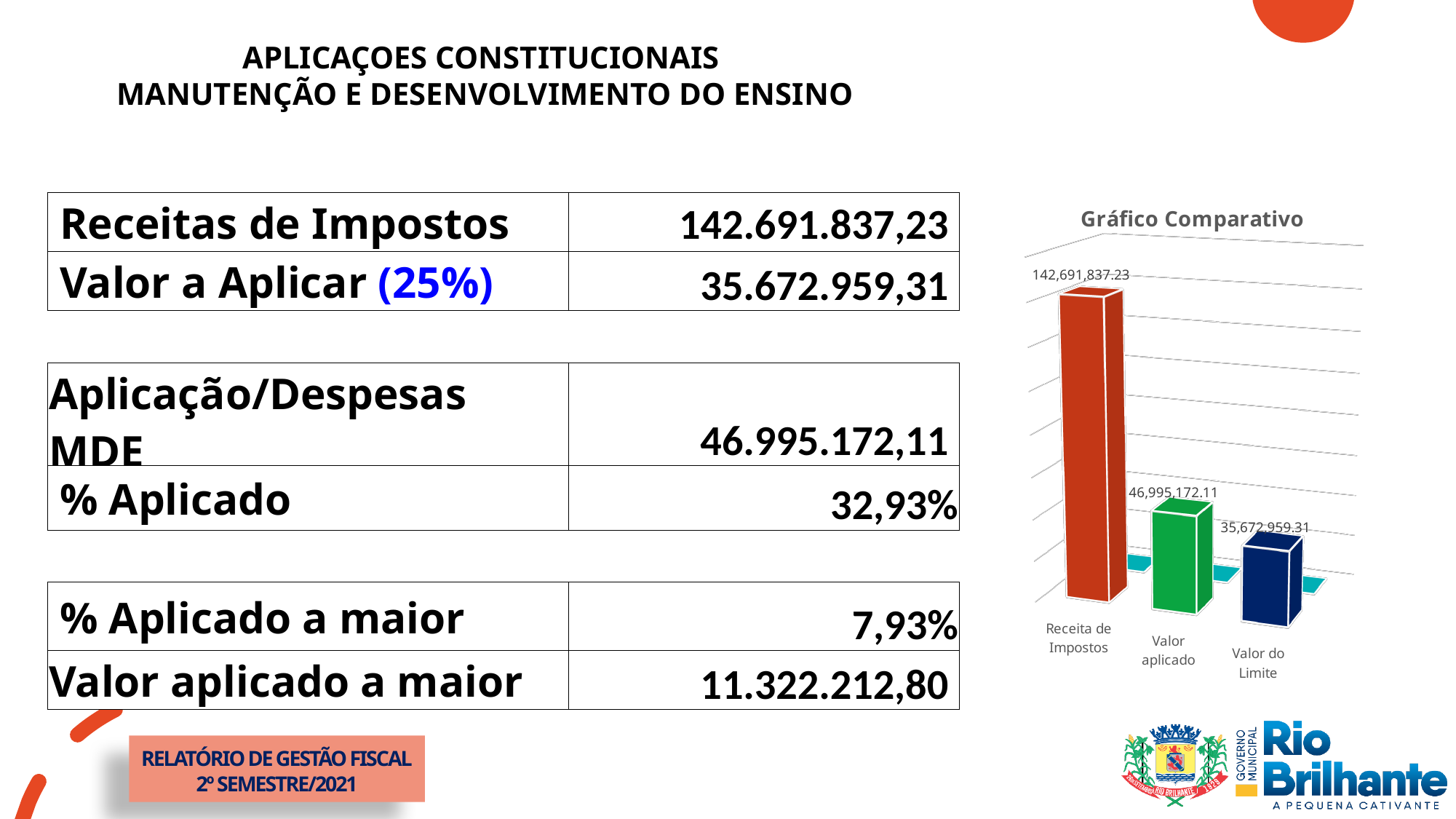
What is the difference between Valor aplicado and Valor do Limite in the chart? 11,322,212.80 Which is larger in the chart, Valor aplicado or Valor do Limite? Valor aplicado Which category has the highest value in the chart? Receita de Impostos Which category has the lowest value in the chart? Valor do Limite What is the value shown for Valor aplicado in the chart? 46,995,172.11 What is the value shown for Valor do Limite in the chart? 35,672,959.31 What is the value shown for Receita de Impostos in the chart? 142,691,837.23 What type of chart is shown on the slide? bar chart What is the difference between Receita de Impostos and Valor aplicado in the chart? 95,696,665.12 What colour is the bar for Valor do Limite in the chart? dark blue How many bars are plotted in the chart? 3 What is the title of the chart on the slide? Gráfico Comparativo